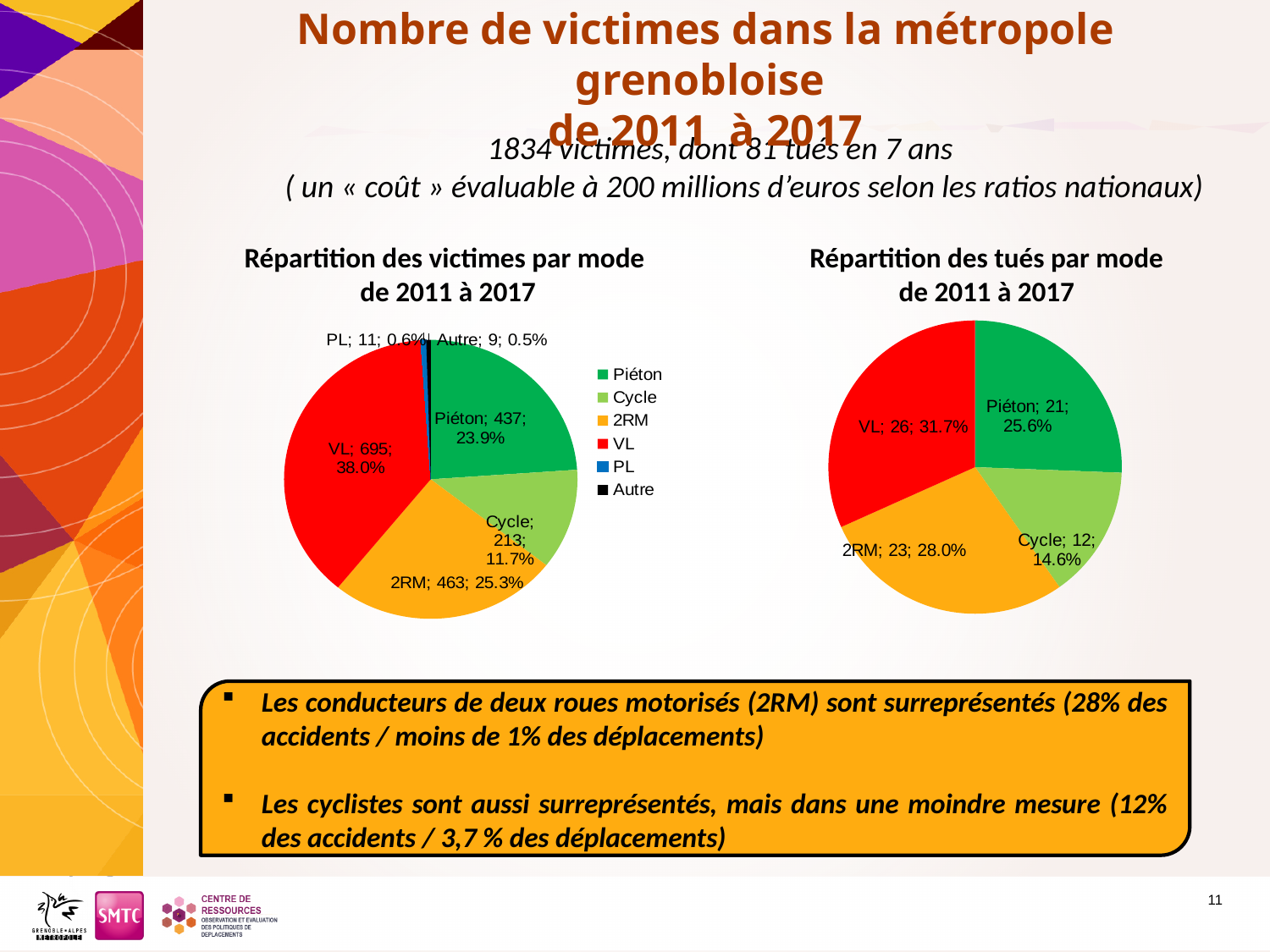
How many slices does the chart 'Répartition des tués par mode de 2011 à 2017' have? 4 In the chart 'Répartition des victimes par mode de 2011 à 2017', what share of victims does the 2RM slice represent? 25.3% In the chart 'Répartition des tués par mode de 2011 à 2017', how many people killed are in the Cycle category? 12 In the chart 'Répartition des victimes par mode de 2011 à 2017', which category has the largest number of victims? VL In the chart 'Répartition des tués par mode de 2011 à 2017', which category has the highest number of people killed? VL In the chart 'Répartition des tués par mode de 2011 à 2017', what share of those killed does the VL slice represent? 31.7% How many categories does the legend of the chart 'Répartition des victimes par mode de 2011 à 2017' list? 6 In the chart 'Répartition des victimes par mode de 2011 à 2017', which category has the smallest number of victims? Autre In the chart 'Répartition des tués par mode de 2011 à 2017', which is larger, the number for 2RM or the number for Piéton? 2RM What type of chart is 'Répartition des tués par mode de 2011 à 2017'? Pie chart In the chart 'Répartition des victimes par mode de 2011 à 2017', how many victims are in the VL category? 695 In the chart 'Répartition des victimes par mode de 2011 à 2017', what is the difference between the number of victims for 2RM and for Piéton? 26